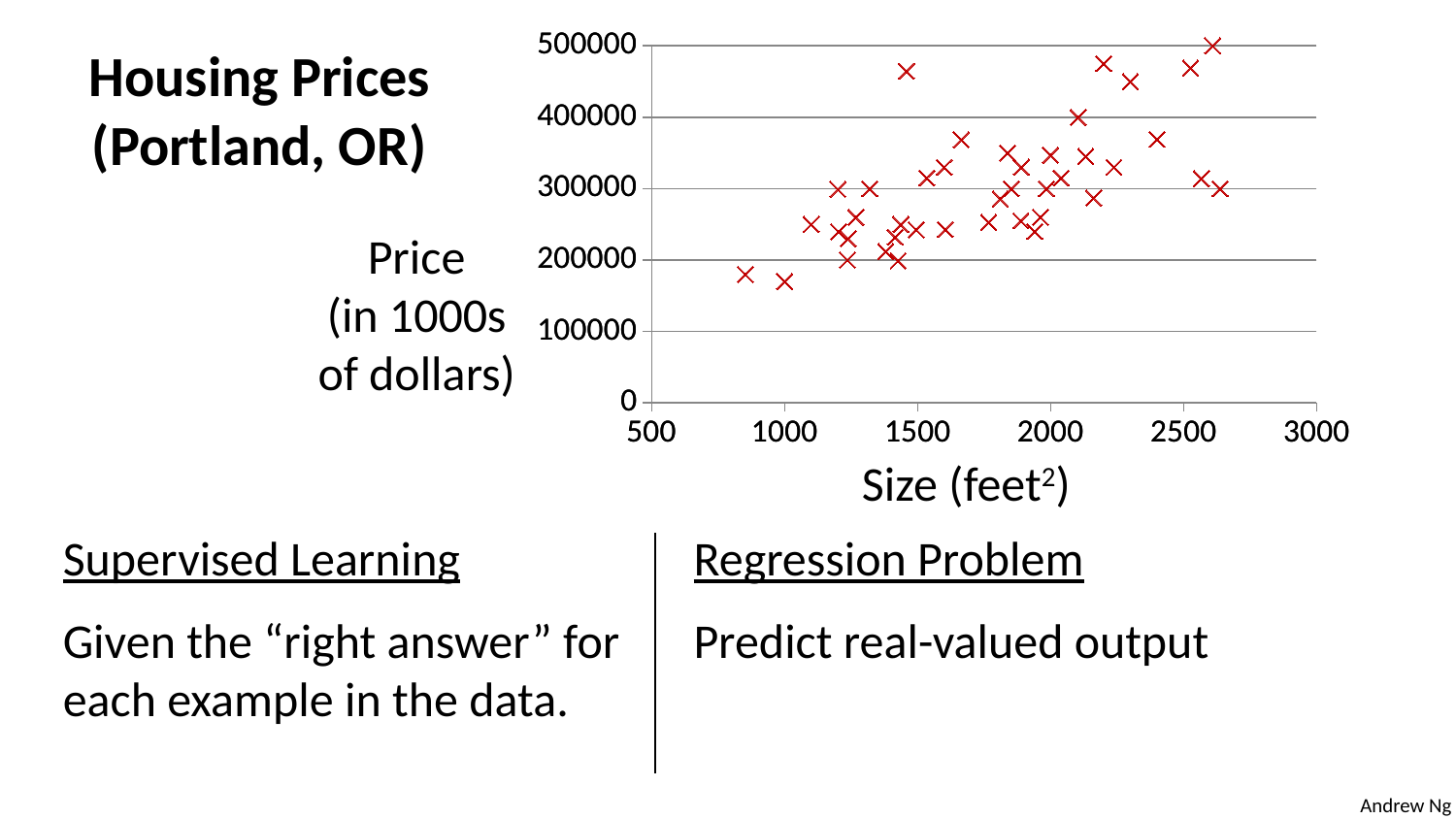
Do the plotted prices generally rise or fall as house size increases along the x axis? rise What is the title of the chart? Housing Prices (Portland, OR) Is the highest price plotted on the chart greater or less than 400000? greater Is the price of the leftmost point (smallest house) greater or less than 200000? less What is the label of the x axis of the chart? Size (feet²) Is the lowest price plotted on the chart greater or less than 200000? less What kind of chart is shown on the slide? scatter plot